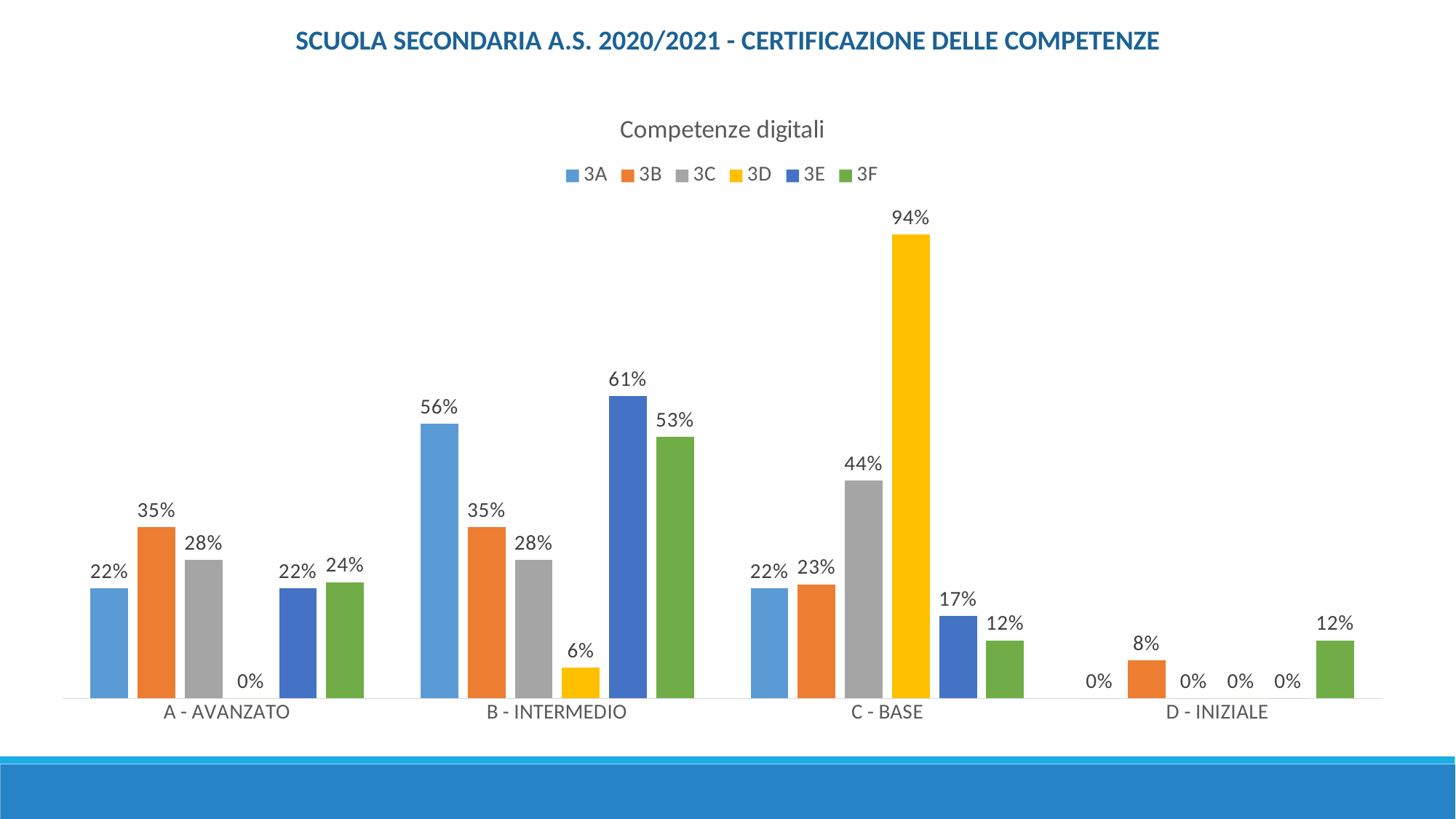
What kind of chart is shown on the slide? Bar chart How many series does the legend list? 6 What is the title of the chart? Competenze digitali What is the difference between the 3E and 3F values in the B - INTERMEDIO category? 8% Which series has the highest value in the C - BASE category? 3D Which is larger in the A - AVANZATO category, the value for 3B or the value for 3C? 3B Which series has the lowest value in the B - INTERMEDIO category? 3D What is the value for 3E in the A - AVANZATO category? 22% What is the value for 3F in the D - INIZIALE category? 12% What is the value for 3D in the C - BASE category? 94% What is the value for 3A in the B - INTERMEDIO category? 56% How many categories are shown on the x axis? 4